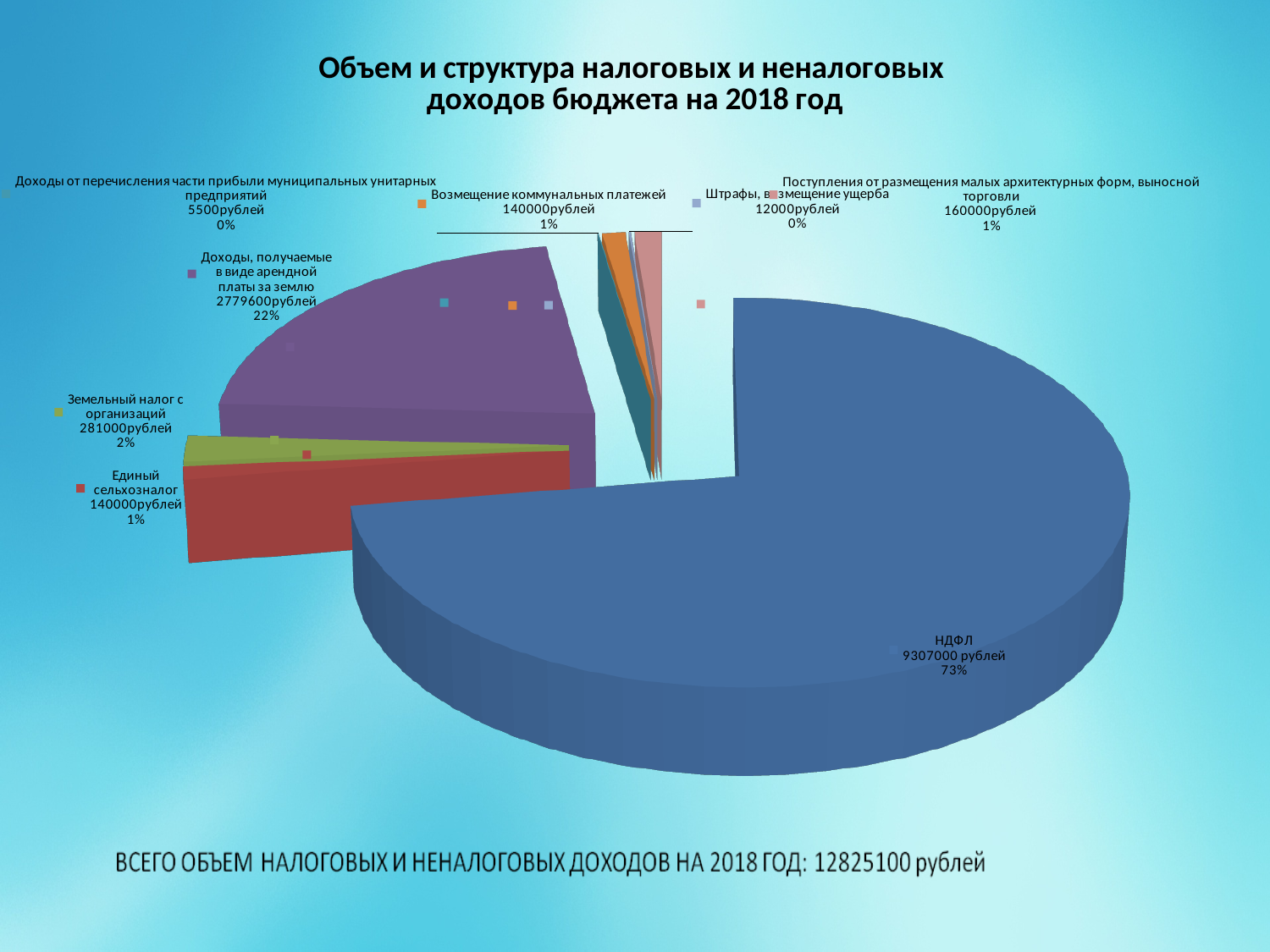
What is the value for НДФЛ? 9307000 рублей What is the difference between the values for НДФЛ and Доходы, получаемые в виде арендной платы за землю? 6527400 рублей What share of the pie does Доходы, получаемые в виде арендной платы за землю represent? 22% How many categories are shown in the pie chart? 8 What is the value for Доходы, получаемые в виде арендной платы за землю? 2779600 рублей Which is larger: Штрафы, возмещение ущерба or Единый сельхозналог? Единый сельхозналог What kind of chart is shown on the slide? pie chart Which category has the smallest value? Доходы от перечисления части прибыли муниципальных унитарных предприятий What share of the pie does НДФЛ represent? 73% Which category has the largest slice of the pie? НДФЛ What is the value for Поступления от размещения малых архитектурных форм, выносной торговли? 160000 рублей What is the value for Земельный налог с организаций? 281000 рублей